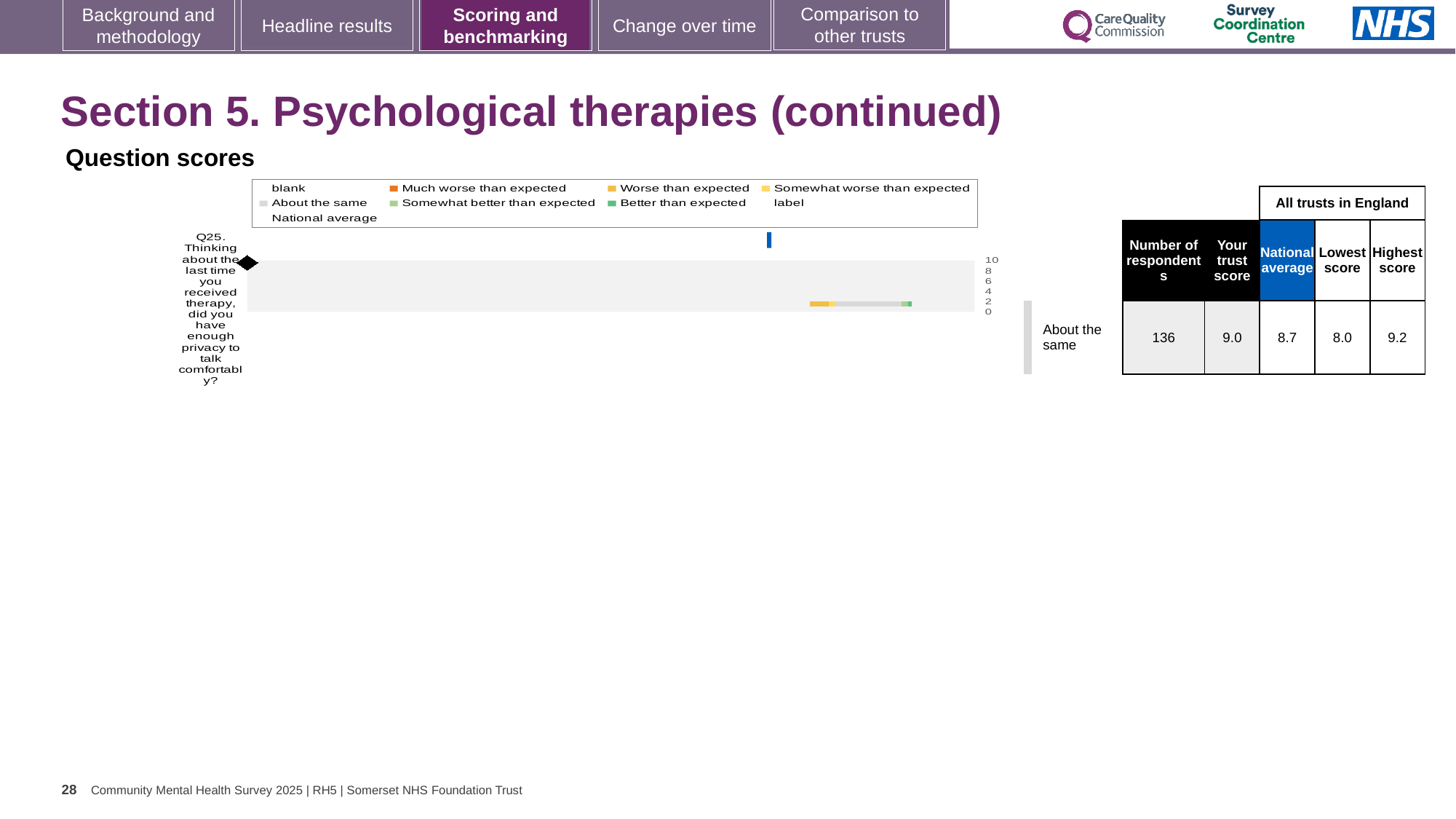
In the table beside the chart, what is your trust score for Q25? 9.0 What kind of chart is shown under 'Question scores'? bar chart Which is larger for Q25, your trust score or the national average? Your trust score How many questions (categories) are plotted in the chart? 1 In the table beside the chart, what is the highest score among all trusts in England for Q25? 9.2 What is the difference between the highest score and the lowest score for Q25 in the table beside the chart? 1.2 In the table beside the chart, what is the national average for Q25? 8.7 What benchmark category is given for Q25 next to the chart? About the same In the table beside the chart, what is the lowest score among all trusts in England for Q25? 8.0 Which question is plotted in the chart? Q25. Thinking about the last time you received therapy, did you have enough privacy to talk comfortably? What is the highest value shown on the chart's axis? 10 In the table beside the chart, what is the number of respondents for Q25? 136